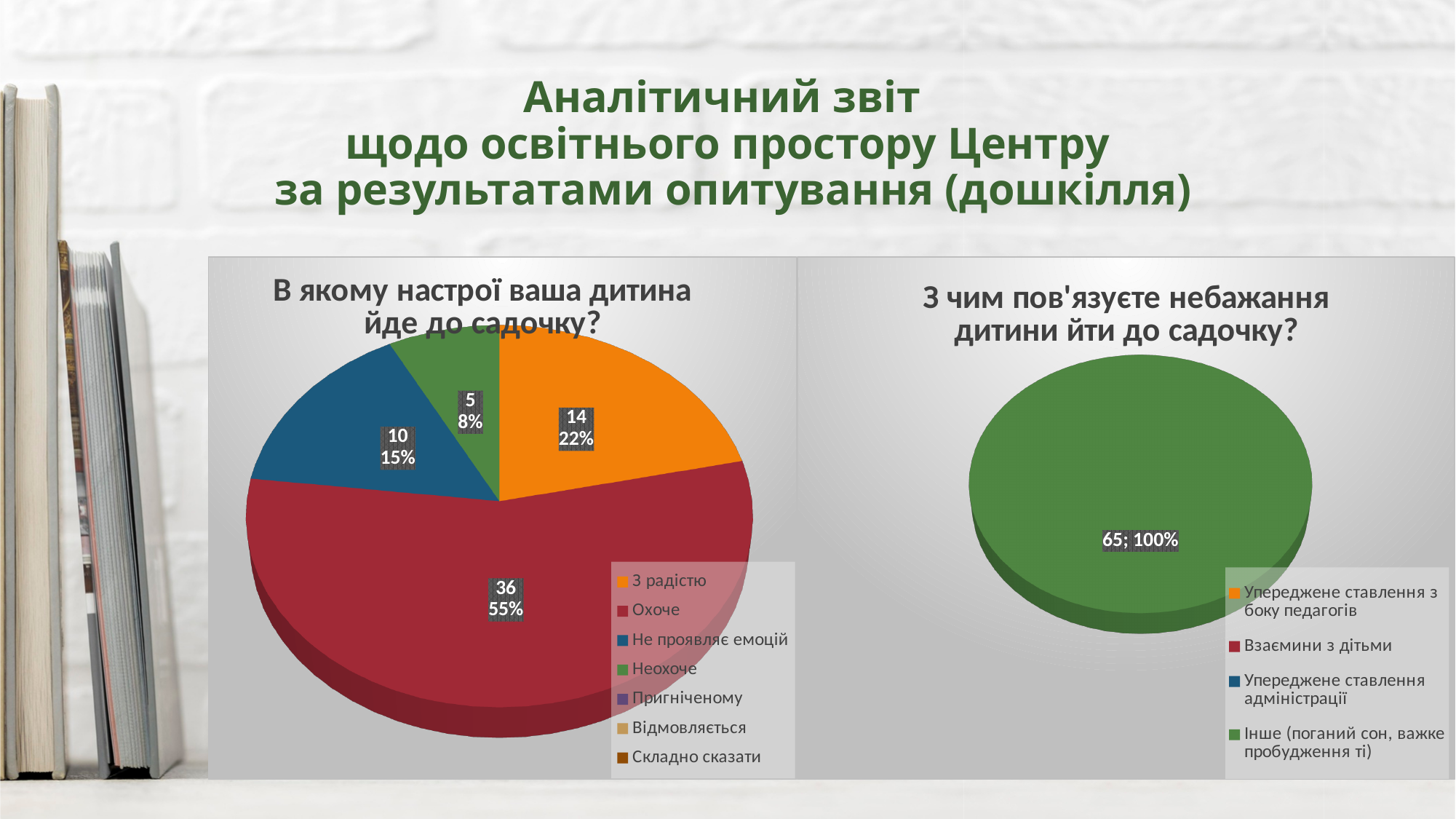
In the left chart 'В якому настрої ваша дитина йде до садочку?', what is the difference between the values for 'Охоче' and 'З радістю'? 22 In the right chart 'З чим пов'язуєте небажання дитини йти до садочку?', what value is shown on the single slice? 65; 100% In the left chart 'В якому настрої ваша дитина йде до садочку?', which category has the largest slice? Охоче In the left chart 'В якому настрої ваша дитина йде до садочку?', which of the labelled slices is the smallest? Неохоче In the left chart 'В якому настрої ваша дитина йде до садочку?', what percentage share does 'З радістю' have? 22% In the left chart 'В якому настрої ваша дитина йде до садочку?', what percentage share does 'Неохоче' have? 8% In the right chart 'З чим пов'язуєте небажання дитини йти до садочку?', which legend category does the green slice correspond to? Інше (поганий сон, важке пробудження ті) In the left chart 'В якому настрої ваша дитина йде до садочку?', which is larger: 'Не проявляє емоцій' or 'Неохоче'? Не проявляє емоцій In the left chart 'В якому настрої ваша дитина йде до садочку?', what is the value for 'Охоче'? 36 What kind of chart is the left chart, 'В якому настрої ваша дитина йде до садочку?'? Pie chart In the left chart 'В якому настрої ваша дитина йде до садочку?', what is the value for 'Не проявляє емоцій'? 10 How many entries does the legend of the left chart 'В якому настрої ваша дитина йде до садочку?' list? 7